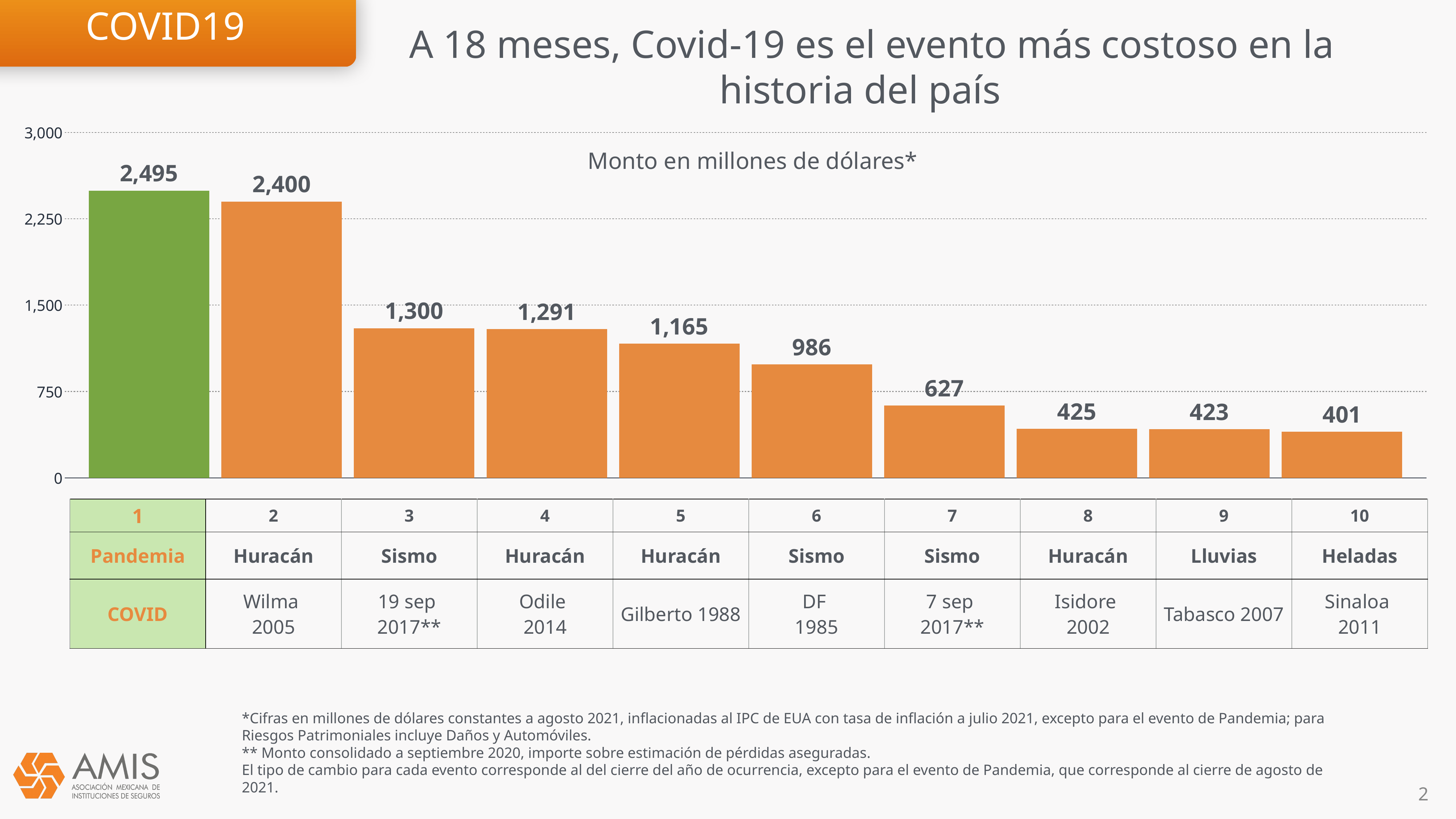
What is the value for Huracán Odile 2014? 1,291 Is the value for Huracán Gilberto 1988 greater or less than 750? greater What is the value for the Pandemia COVID bar? 2,495 Which event has the highest value? Pandemia COVID What is the value for Huracán Wilma 2005? 2,400 What kind of chart is shown on the slide? bar chart Which event has the lowest value? Heladas Sinaloa 2011 How many events are shown in the chart? 10 What unit does the chart subtitle say the amounts are in? Monto en millones de dólares Which is larger, the value for Sismo 19 sep 2017 or the value for Sismo 7 sep 2017? Sismo 19 sep 2017 What is the value for Sismo DF 1985? 986 What is the difference between the Pandemia COVID value and the Huracán Wilma 2005 value? 95